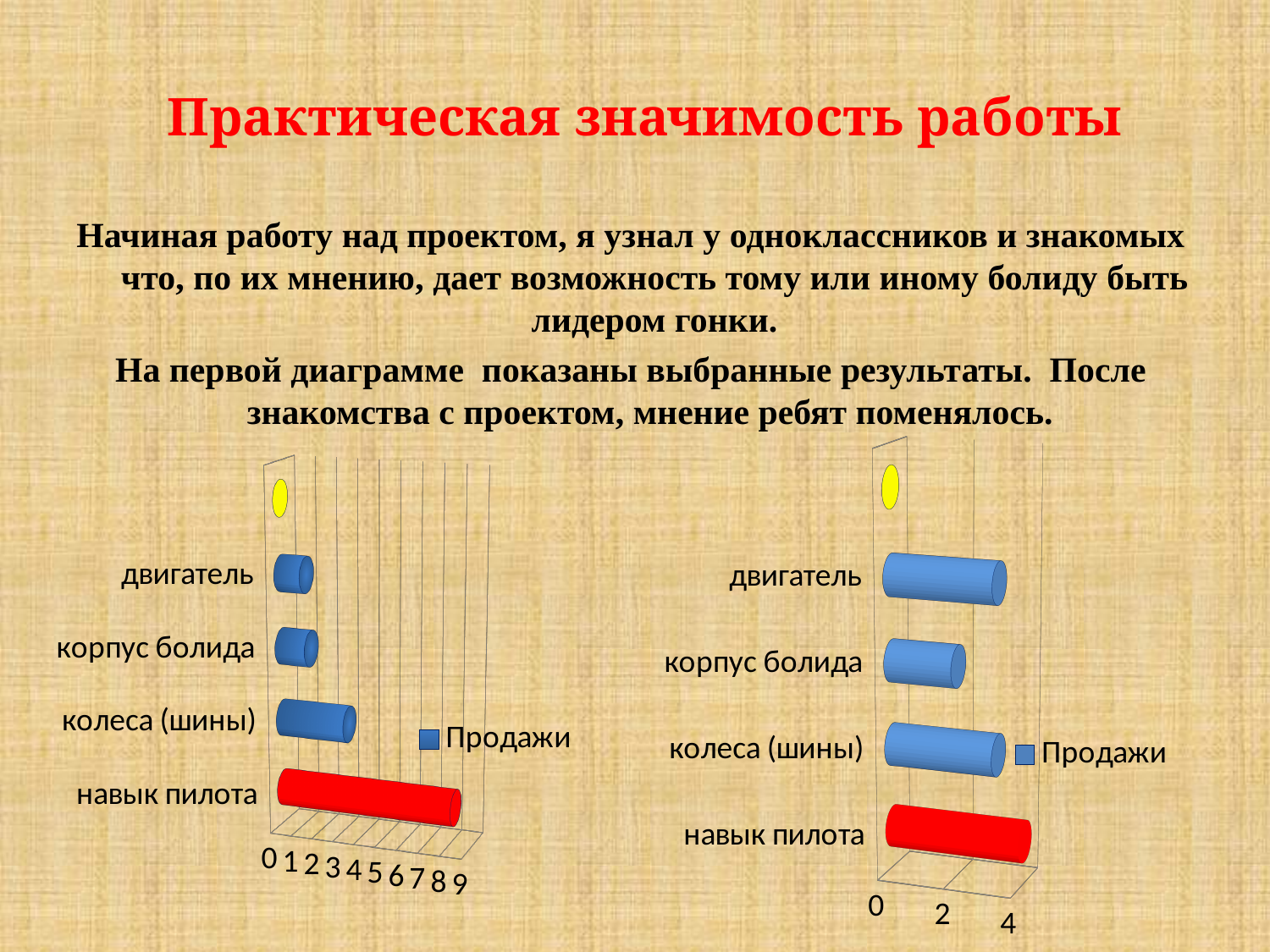
In the left chart, which is larger: the value for колеса (шины) or the value for двигатель? колеса (шины) In the left chart, is the value for навык пилота greater or less than 5? greater In the left chart, which category has the highest value? навык пилота In the right chart, is the value for корпус болида greater or less than 4? less How many categories does the left chart show? 4 What kind of chart is the left chart on the slide? bar chart In the right chart, which category has the lowest value? корпус болида What is the legend entry shown on the left chart? Продажи In the right chart, which category has the highest value? навык пилота How many series does the legend of the right chart list? 1 In the left chart, is the value for колеса (шины) greater or less than 5? less